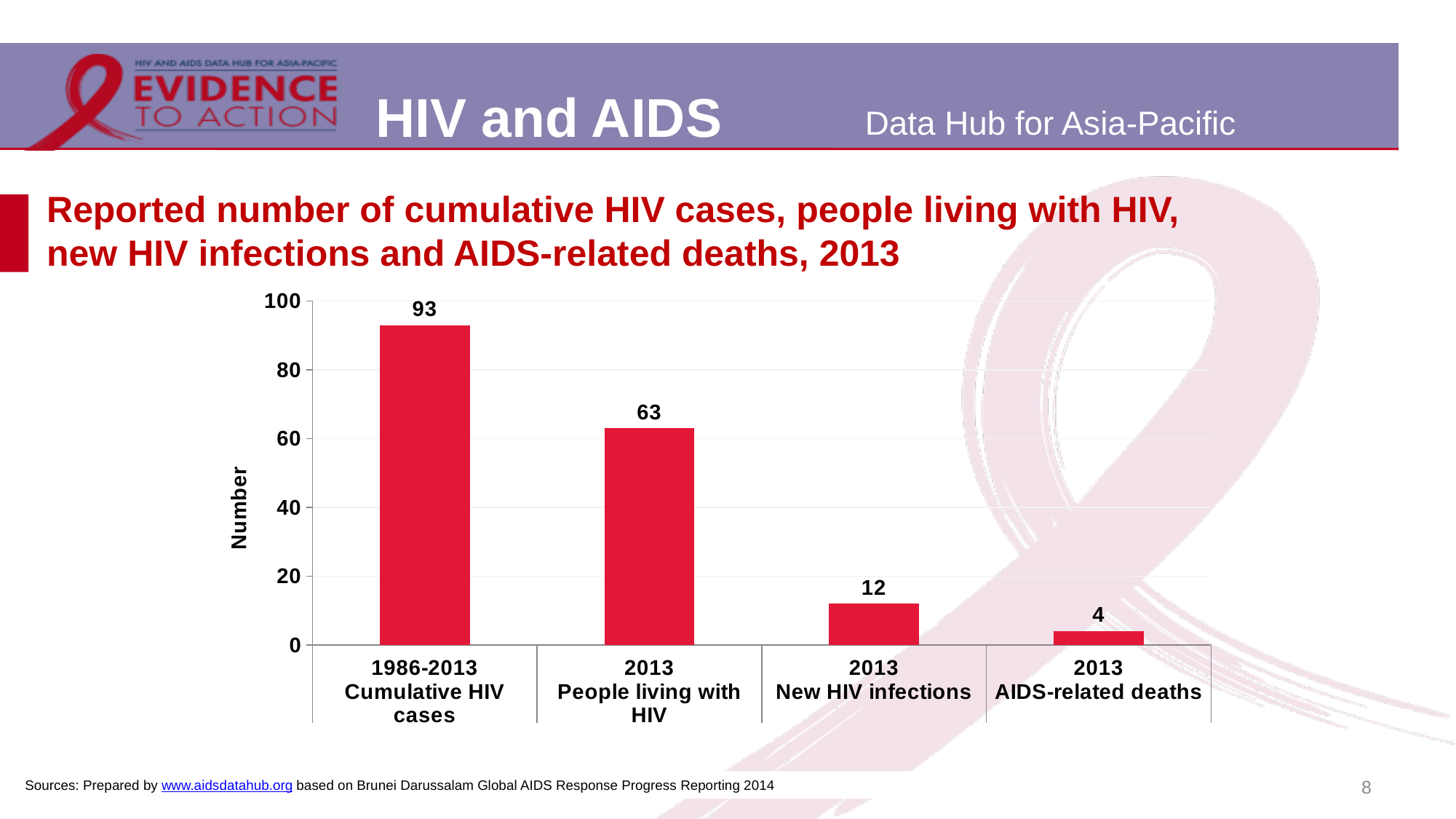
What is the reported number of cumulative HIV cases for 1986-2013? 93 What kind of chart is shown on the slide? Bar chart What is the reported number of people living with HIV in 2013? 63 What is the label of the vertical axis? Number What is the difference between cumulative HIV cases (1986-2013) and people living with HIV (2013)? 30 Which is larger: people living with HIV in 2013 or new HIV infections in 2013? People living with HIV How many categories are shown on the chart? 4 What is the difference between new HIV infections and AIDS-related deaths in 2013? 8 Which category has the lowest value? 2013 AIDS-related deaths Which category has the highest value? 1986-2013 Cumulative HIV cases What is the reported number of new HIV infections in 2013? 12 What is the reported number of AIDS-related deaths in 2013? 4